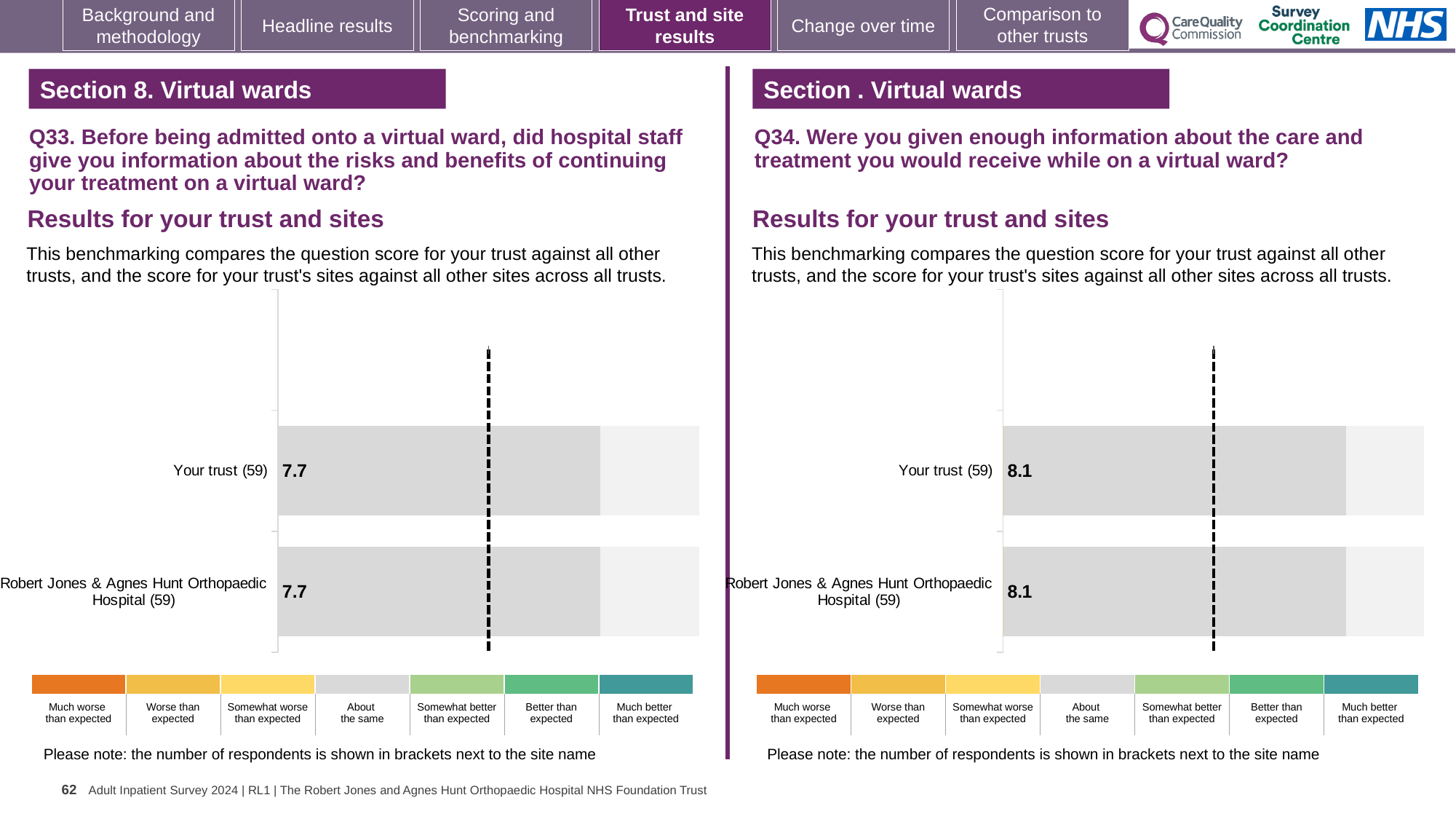
In the Q34 chart on the right, what is the score for Robert Jones & Agnes Hunt Orthopaedic Hospital? 8.1 In the Q33 chart on the left, what is the score for Robert Jones & Agnes Hunt Orthopaedic Hospital? 7.7 How many benchmark categories does the colour key below the Q34 chart on the right list? 7 In the Q33 chart on the left, what is the score for Your trust? 7.7 How many bars are plotted in the Q34 chart on the right? 2 In the Q33 chart on the left, how many respondents are shown in brackets next to Your trust? 59 What kind of chart is used for the Q33 results on the left? Bar chart In the Q34 chart on the right, what is the score for Your trust? 8.1 In the Q34 chart on the right, what is the difference between the score for Your trust and the score for Robert Jones & Agnes Hunt Orthopaedic Hospital? 0 How many bars are plotted in the Q33 chart on the left? 2 In the colour key below the Q33 chart on the left, which category is shown in grey? About the same In the Q33 chart on the left, what is the difference between the score for Your trust and the score for Robert Jones & Agnes Hunt Orthopaedic Hospital? 0